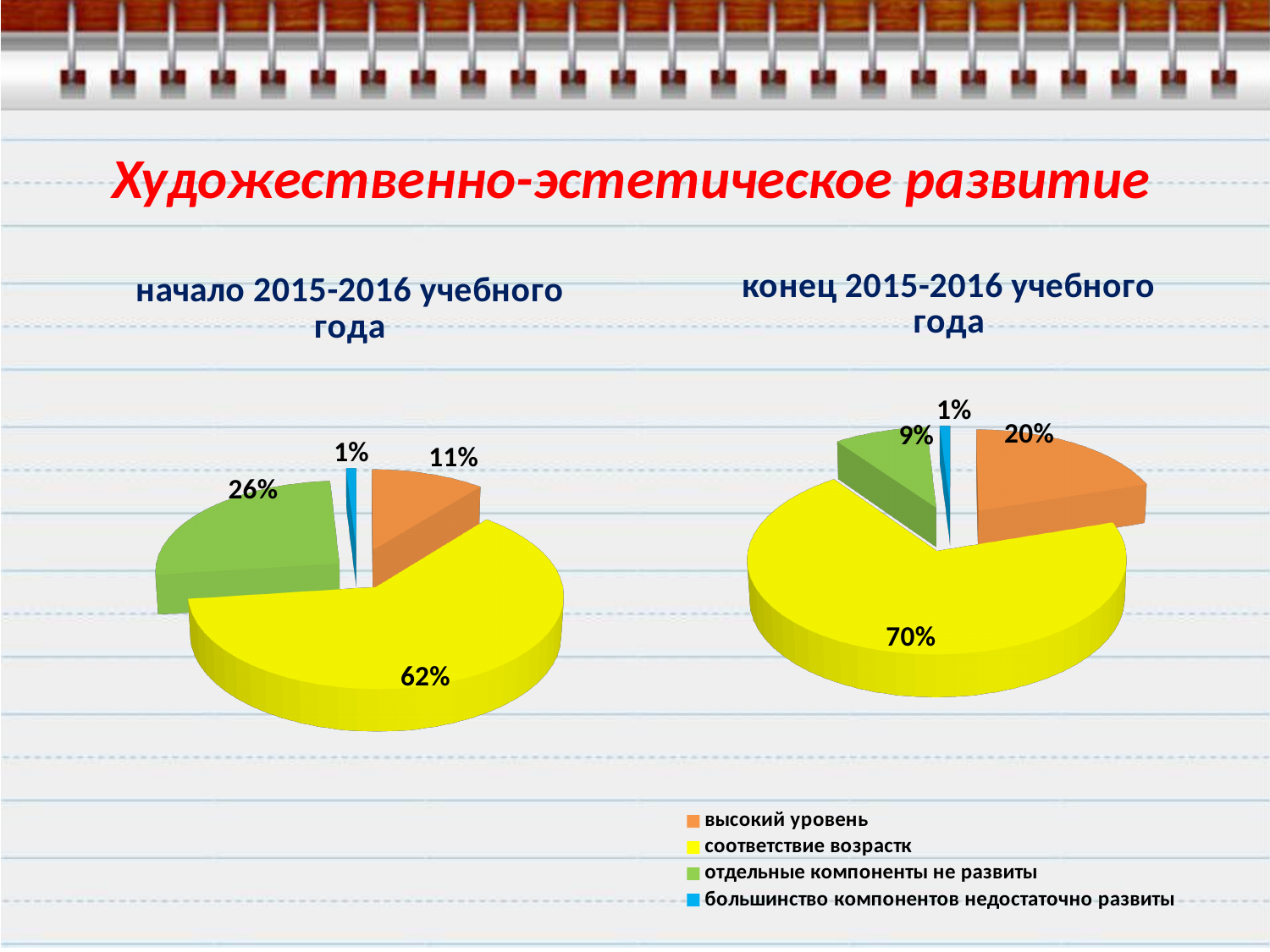
In the chart titled "конец 2015-2016 учебного года", what is the value for "соответствие возрасту"? 70% What is the difference between the "высокий уровень" value in the chart titled "конец 2015-2016 учебного года" and the "высокий уровень" value in the chart titled "начало 2015-2016 учебного года"? 9% What type of chart is the chart titled "конец 2015-2016 учебного года"? Pie chart In the chart titled "конец 2015-2016 учебного года", what is the value for "высокий уровень"? 20% In the chart titled "начало 2015-2016 учебного года", what is the value for "высокий уровень"? 11% In the chart titled "начало 2015-2016 учебного года", which category has the largest share? соответствие возрастк Which is larger: "отдельные компоненты не развиты" in the chart titled "начало 2015-2016 учебного года" or "отдельные компоненты не развиты" in the chart titled "конец 2015-2016 учебного года"? начало 2015-2016 учебного года In the chart titled "конец 2015-2016 учебного года", what is the difference between "соответствие возрасту" and "отдельные компоненты не развиты"? 61% In the chart titled "начало 2015-2016 учебного года", what is the value for "отдельные компоненты не развиты"? 26% In the chart titled "конец 2015-2016 учебного года", which category has the smallest share? большинство компонентов недостаточно развиты How many slices does the chart titled "начало 2015-2016 учебного года" have? 4 How many entries does the legend on the slide list? 4